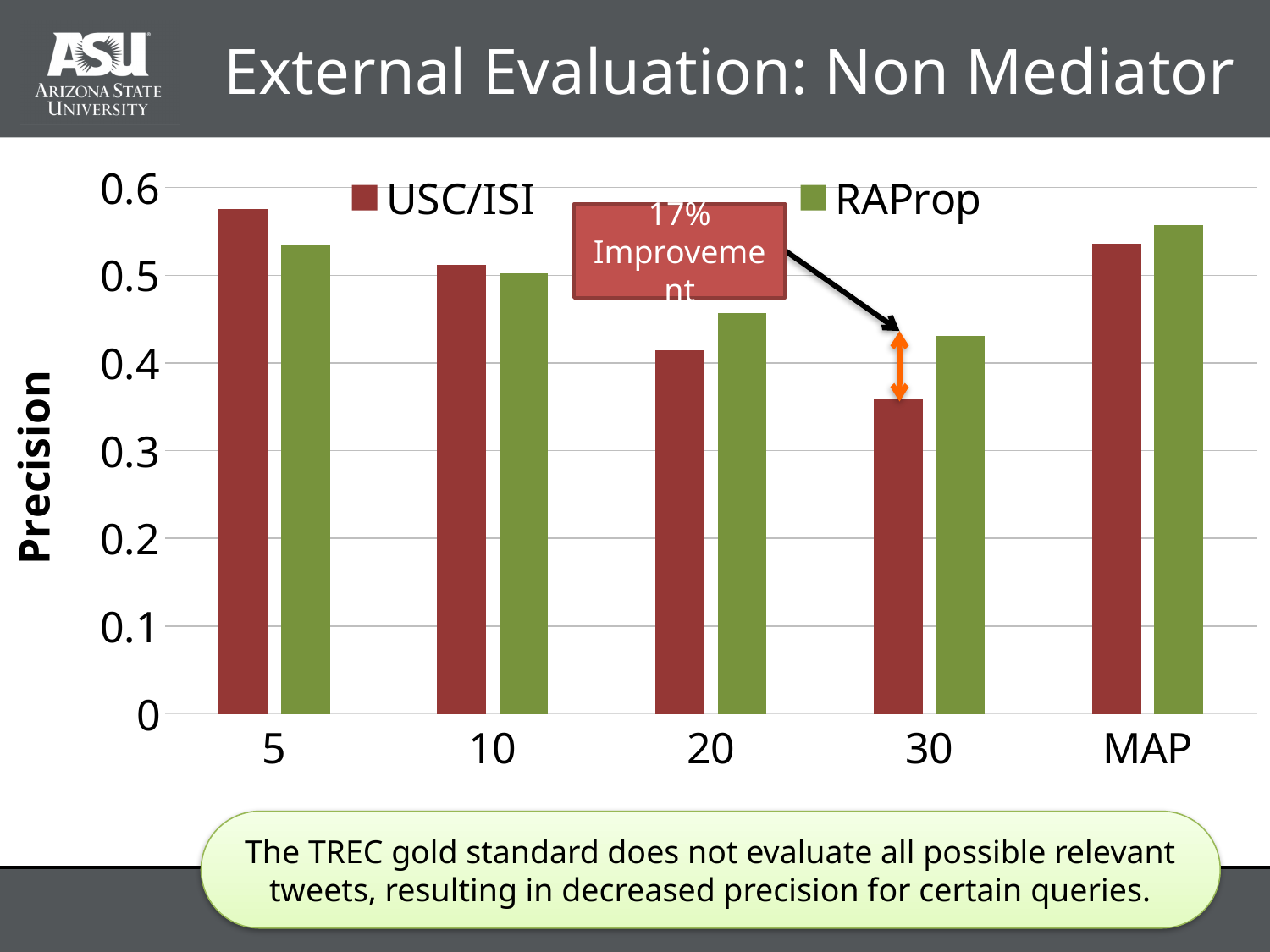
Is the USC/ISI value at 5 greater or less than 0.5? greater At which category is the USC/ISI precision lowest? 30 Is the USC/ISI value at 30 greater or less than 0.4? less At 5, which series has the higher precision, USC/ISI or RAProp? USC/ISI Is the RAProp value at 30 greater or less than 0.4? greater How many categories are shown on the x axis? 5 At 30, which series has the higher precision, USC/ISI or RAProp? RAProp What kind of chart is shown on the slide? bar chart How many series does the legend list? 2 What is the label on the y axis? Precision Do the USC/ISI values rise or fall from 5 to 30 along the x axis? fall